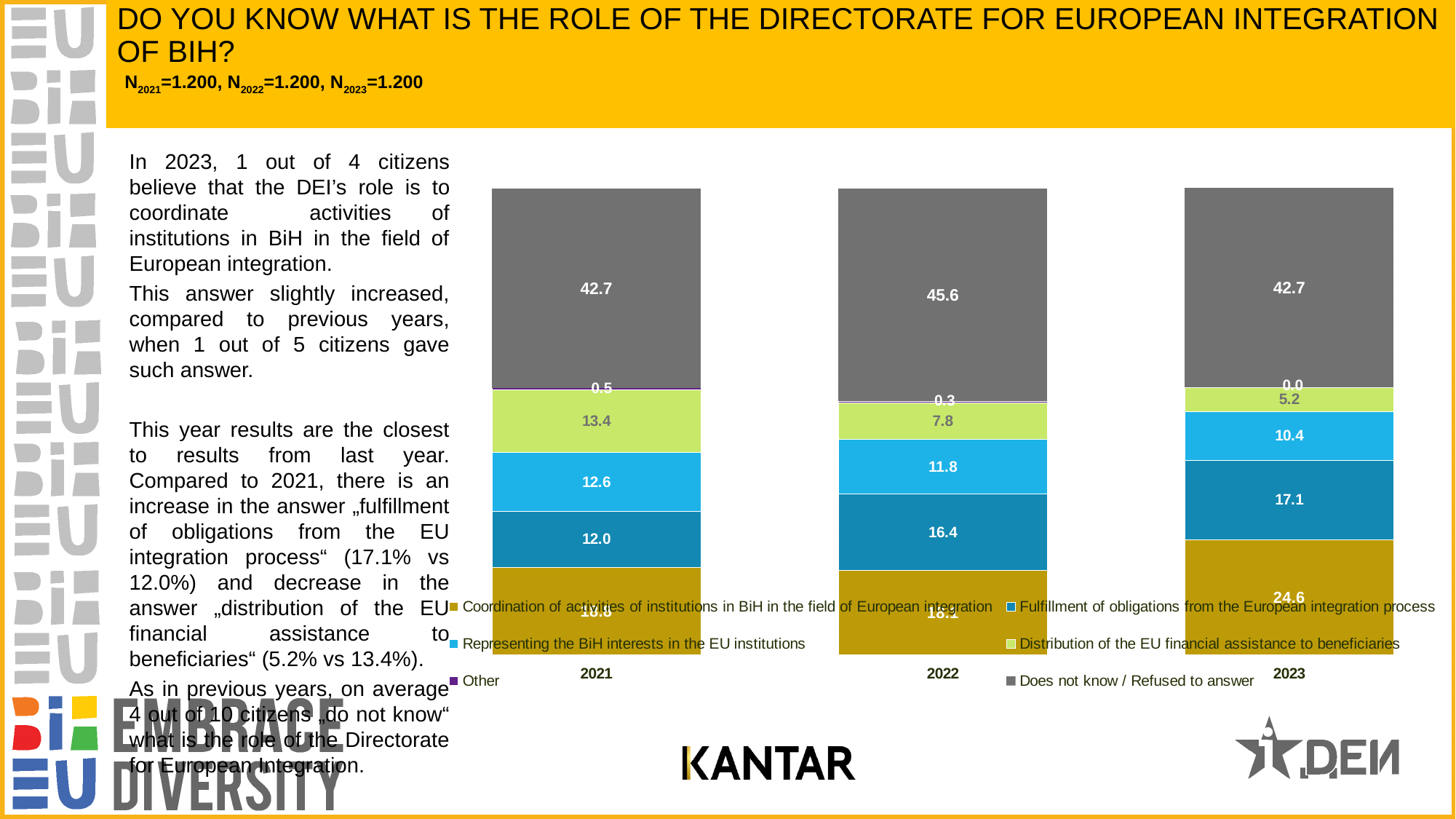
How many series does the legend list? 6 What is the value for 'Representing the BiH interests in the EU institutions' in 2022? 11.8 What is the value for 'Does not know / Refused to answer' in 2022? 45.6 How many years are shown on the x axis of the chart? 3 In which year is the 'Does not know / Refused to answer' value highest? 2022 In which year is the 'Distribution of the EU financial assistance to beneficiaries' value lowest? 2023 What kind of chart is shown on the slide? Stacked bar chart What is the value for 'Distribution of the EU financial assistance to beneficiaries' in 2021? 13.4 Which year has the larger value for 'Representing the BiH interests in the EU institutions', 2021 or 2023? 2021 What is the value for 'Fulfillment of obligations from the European integration process' in 2023? 17.1 What is the difference between the 'Fulfillment of obligations from the European integration process' values in 2023 and 2021? 5.1 What is the value for 'Other' in 2023? 0.0